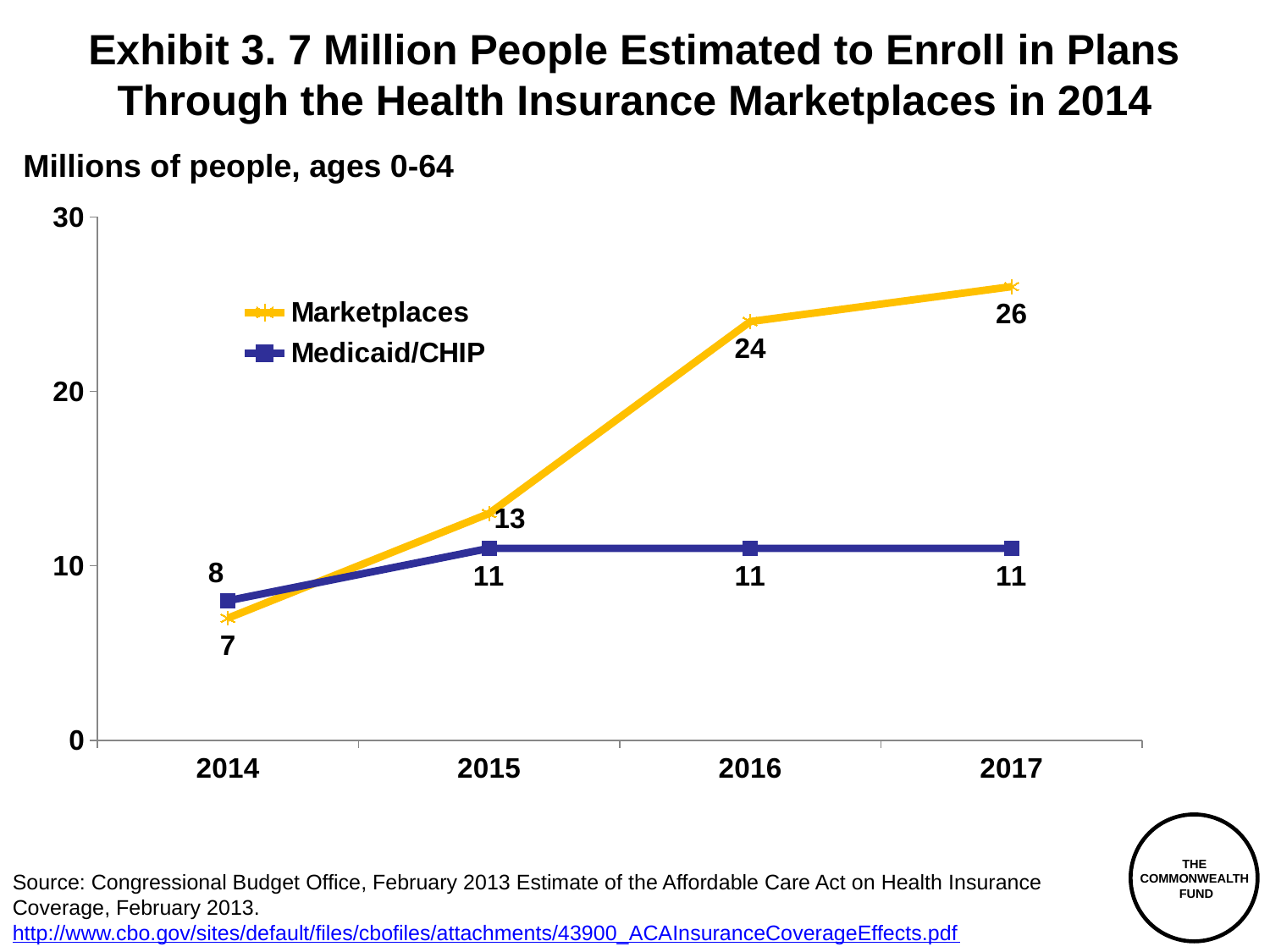
What is the Marketplaces value for 2017? 26 Which series has the larger value in 2014, Marketplaces or Medicaid/CHIP? Medicaid/CHIP In which year is the Medicaid/CHIP value lowest? 2014 How many series does the legend list? 2 Is the Marketplaces value for 2016 greater or less than 20? greater How many years are shown on the x axis? 4 What is the Marketplaces value for 2014? 7 In which year is the Marketplaces value highest? 2017 What kind of chart is shown on the slide? line chart Does the Marketplaces series rise or fall from 2014 to 2017? rise What is the Medicaid/CHIP value for 2015? 11 What is the difference between the Marketplaces and Medicaid/CHIP values in 2016? 13